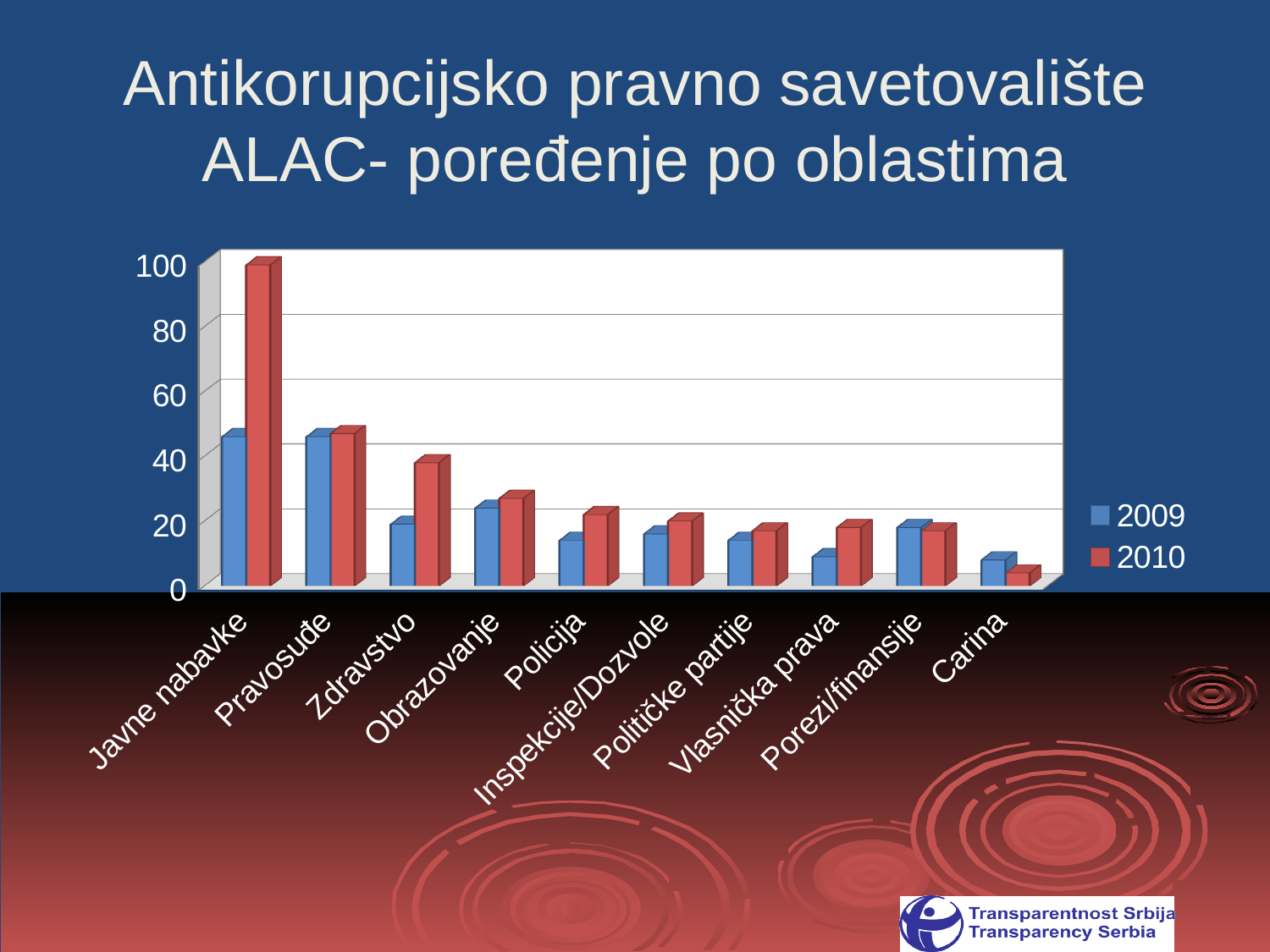
Is the 2009 value for Pravosuđe greater or less than 40? greater Which two years are listed in the legend? 2009 and 2010 Is the 2010 value for Javne nabavke greater or less than 80? greater Which category has the highest value for 2010? Javne nabavke Which category has the lowest value for 2010? Carina For Javne nabavke, which series has the larger value, 2009 or 2010? 2010 How many categories are shown on the x axis? 10 Is the 2010 value for Zdravstvo greater or less than 20? greater How many series does the legend list? 2 What kind of chart is shown on the slide? bar chart For Carina, which series has the larger value, 2009 or 2010? 2009